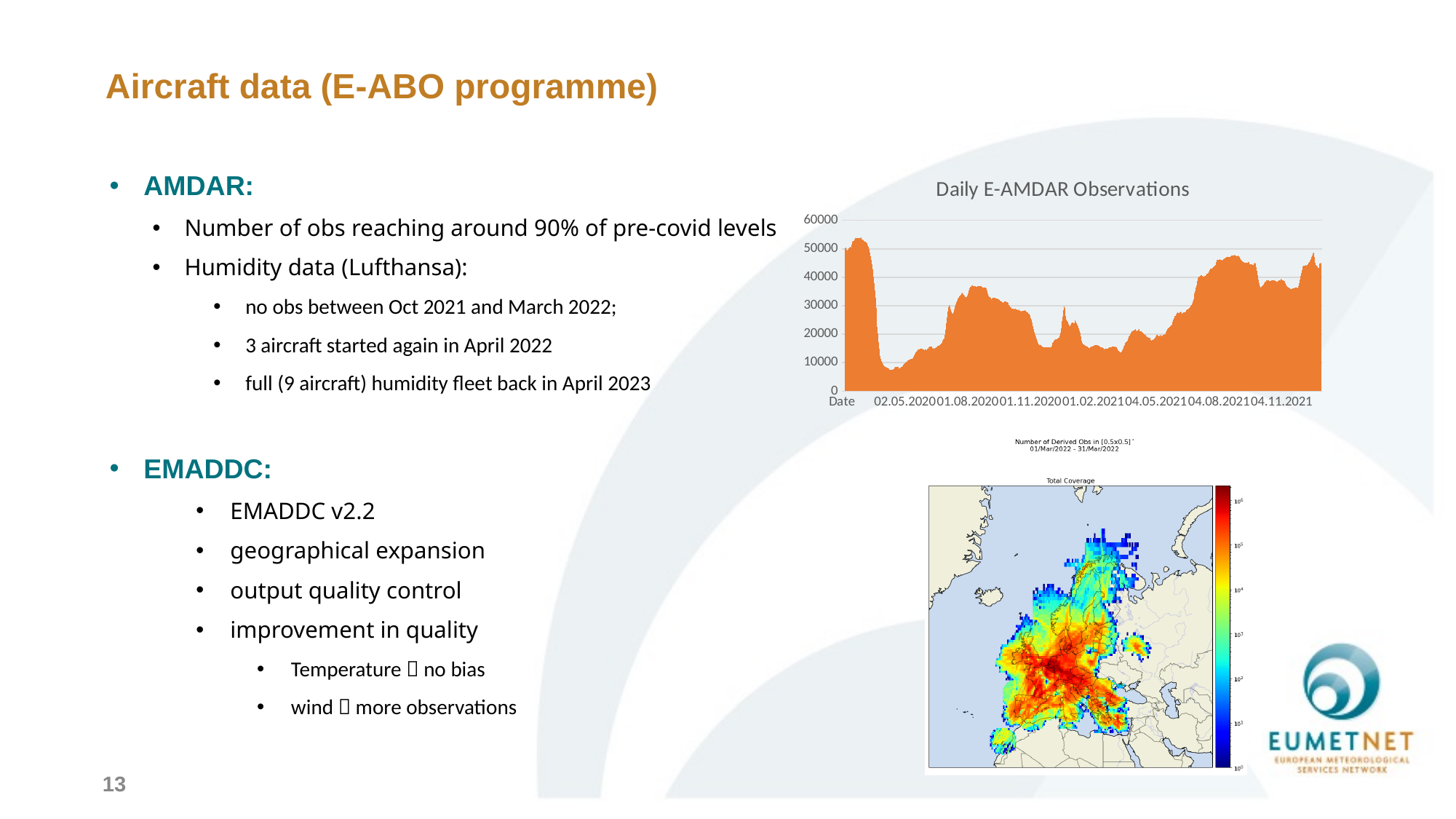
In the Daily E-AMDAR Observations chart, what is the highest value shown on the vertical axis? 60000 In the Daily E-AMDAR Observations chart, is the value at 01.08.2020 greater or less than 20000? greater In the Daily E-AMDAR Observations chart, is the value at 04.11.2021 greater or less than 30000? greater In the Daily E-AMDAR Observations chart, do the values rise or fall between 02.05.2020 and 01.08.2020? rise In the Daily E-AMDAR Observations chart, how many dates are labelled on the horizontal axis? 7 What is the title of the chart at the top right of the slide? Daily E-AMDAR Observations In the Daily E-AMDAR Observations chart, is the value at 04.08.2021 greater or less than 40000? greater In the Daily E-AMDAR Observations chart, what kind of chart is used to show the data? area chart In the Daily E-AMDAR Observations chart, do the values rise or fall between 04.05.2021 and 04.08.2021? rise In the Daily E-AMDAR Observations chart, which is larger, the value at 04.08.2021 or the value at 01.02.2021? 04.08.2021